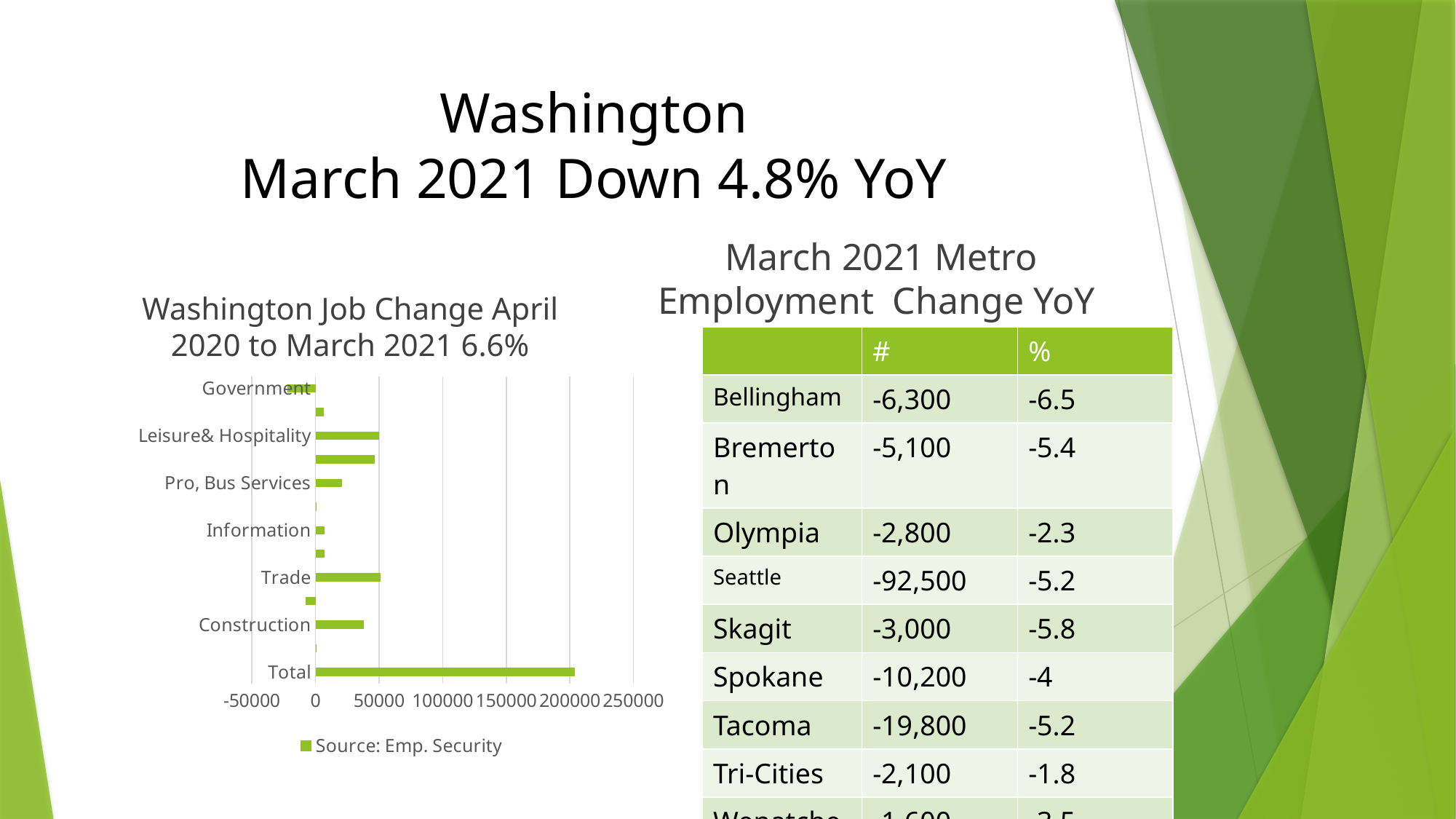
What is the legend entry shown below the chart? Source: Emp. Security Which category has the highest value in the Washington Job Change chart? Total Which is larger, the value for Total or the value for Trade? Total Is the value for Construction greater or less than 50000? less Which is larger, the value for Construction or the value for Pro, Bus Services? Construction What is the title of the bar chart? Washington Job Change April 2020 to March 2021 6.6% Is the value for Pro, Bus Services greater or less than 50000? less Is the value for Information greater or less than 50000? less What kind of chart is shown on the slide? bar chart How many series does the chart legend list? 1